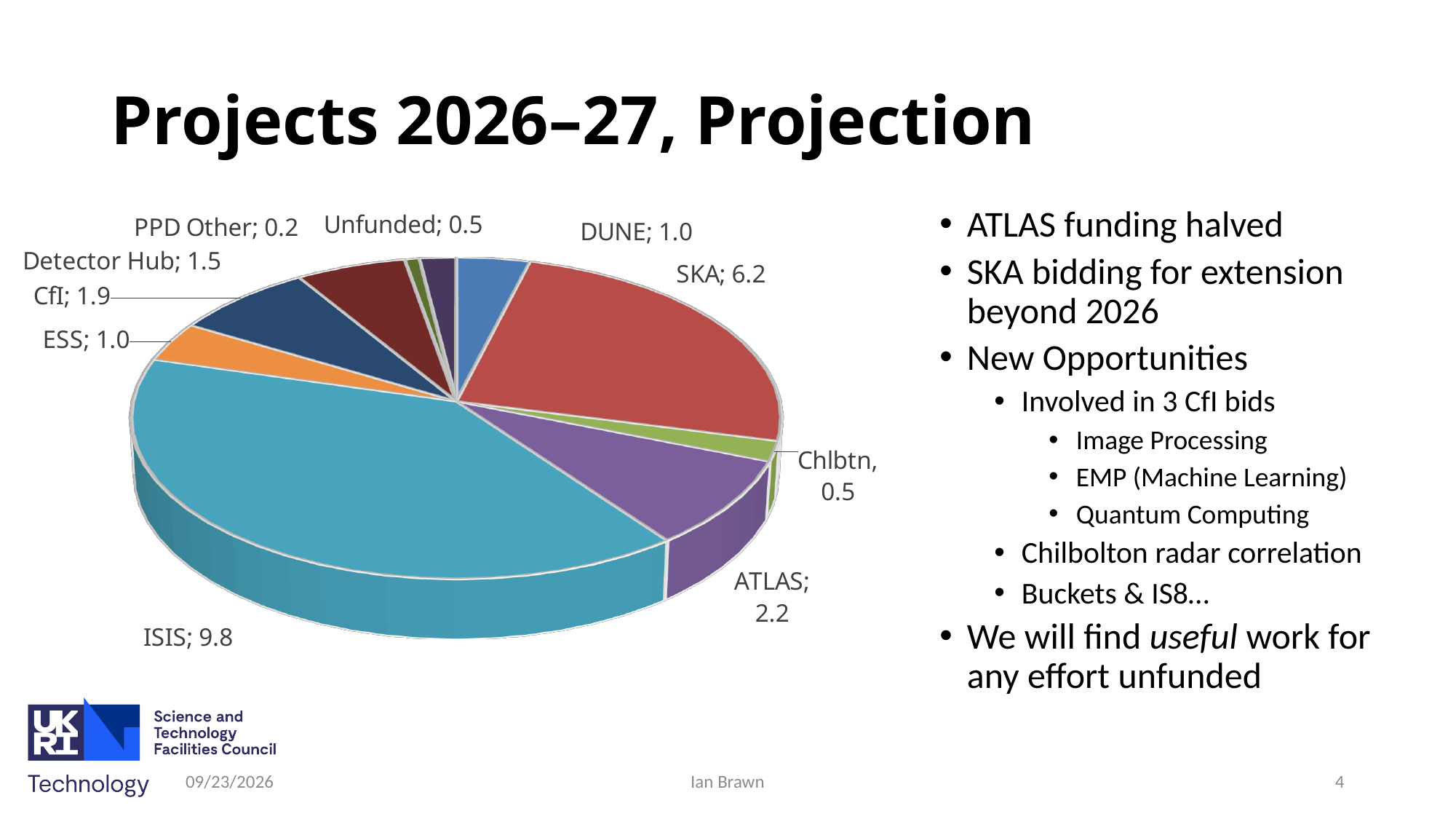
Which slice of the pie chart has the smallest value? PPD Other What is the value shown for ISIS in the pie chart? 9.8 What is the title of the slide containing the chart? Projects 2026–27, Projection What is the value shown for SKA in the pie chart? 6.2 How many slices does the pie chart have? 10 What is the value shown for ATLAS in the pie chart? 2.2 What is the difference between the SKA value and the ATLAS value in the pie chart? 4.0 What type of chart is shown on the slide? Pie chart Which has the larger value in the pie chart, CfI or Detector Hub? CfI What is the value shown for Detector Hub in the pie chart? 1.5 What is the difference between the ISIS value and the SKA value in the pie chart? 3.6 Which slice of the pie chart has the largest value? ISIS